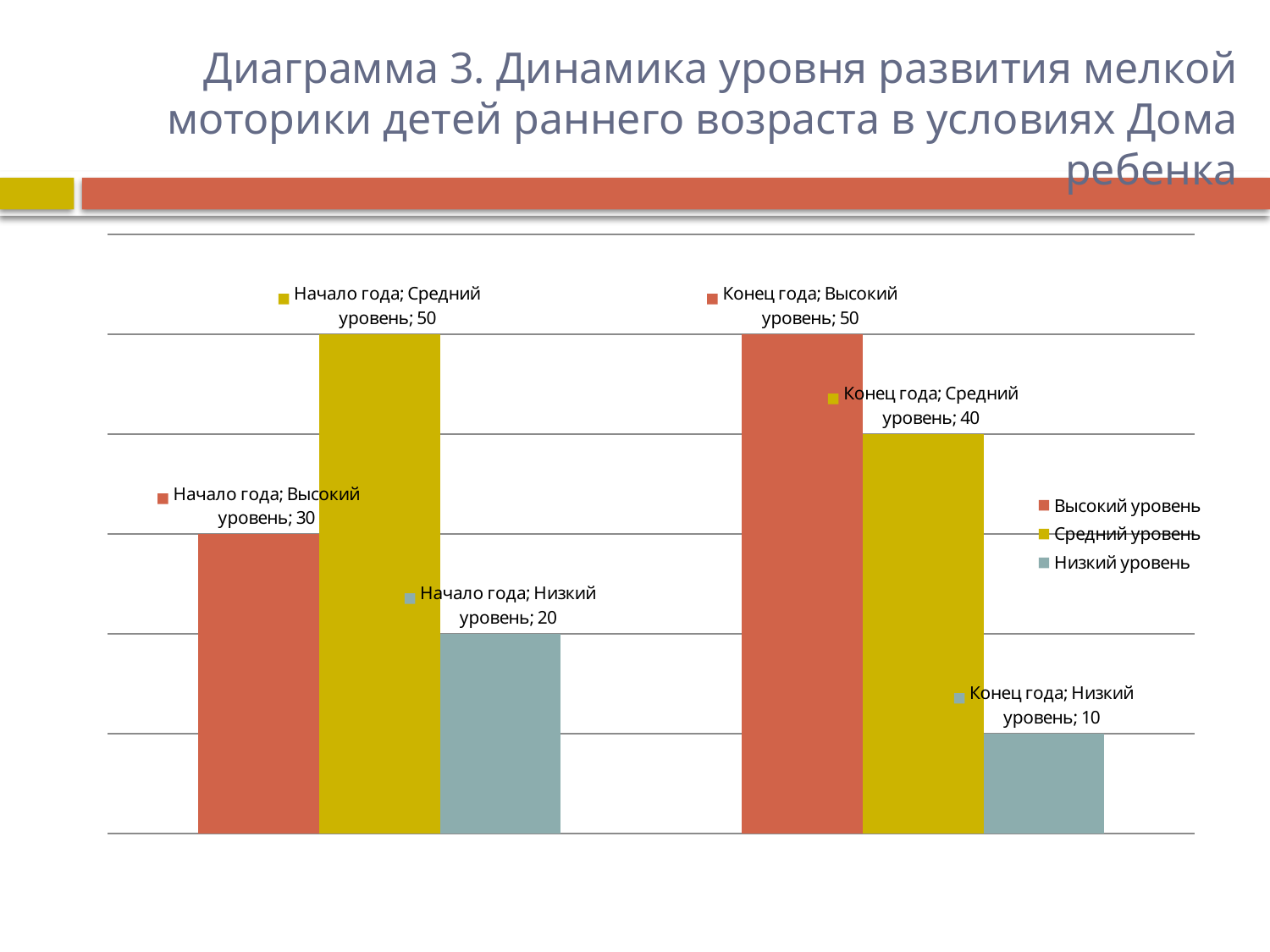
What is the difference between the Высокий уровень values at Конец года and Начало года? 20 What kind of chart is shown on the slide? Bar chart Does the value for Низкий уровень rise or fall from Начало года to Конец года? Fall What is the value for Средний уровень at Конец года? 40 What is the value for Низкий уровень at Конец года? 10 What is the value for Низкий уровень at Начало года? 20 Which level has the highest value at Конец года? Высокий уровень How many categories are shown on the x axis? 2 Which is larger: Средний уровень at Начало года or Средний уровень at Конец года? Средний уровень at Начало года How many series does the legend list? 3 Which level has the lowest value at Начало года? Низкий уровень What is the value for Высокий уровень at Начало года? 30